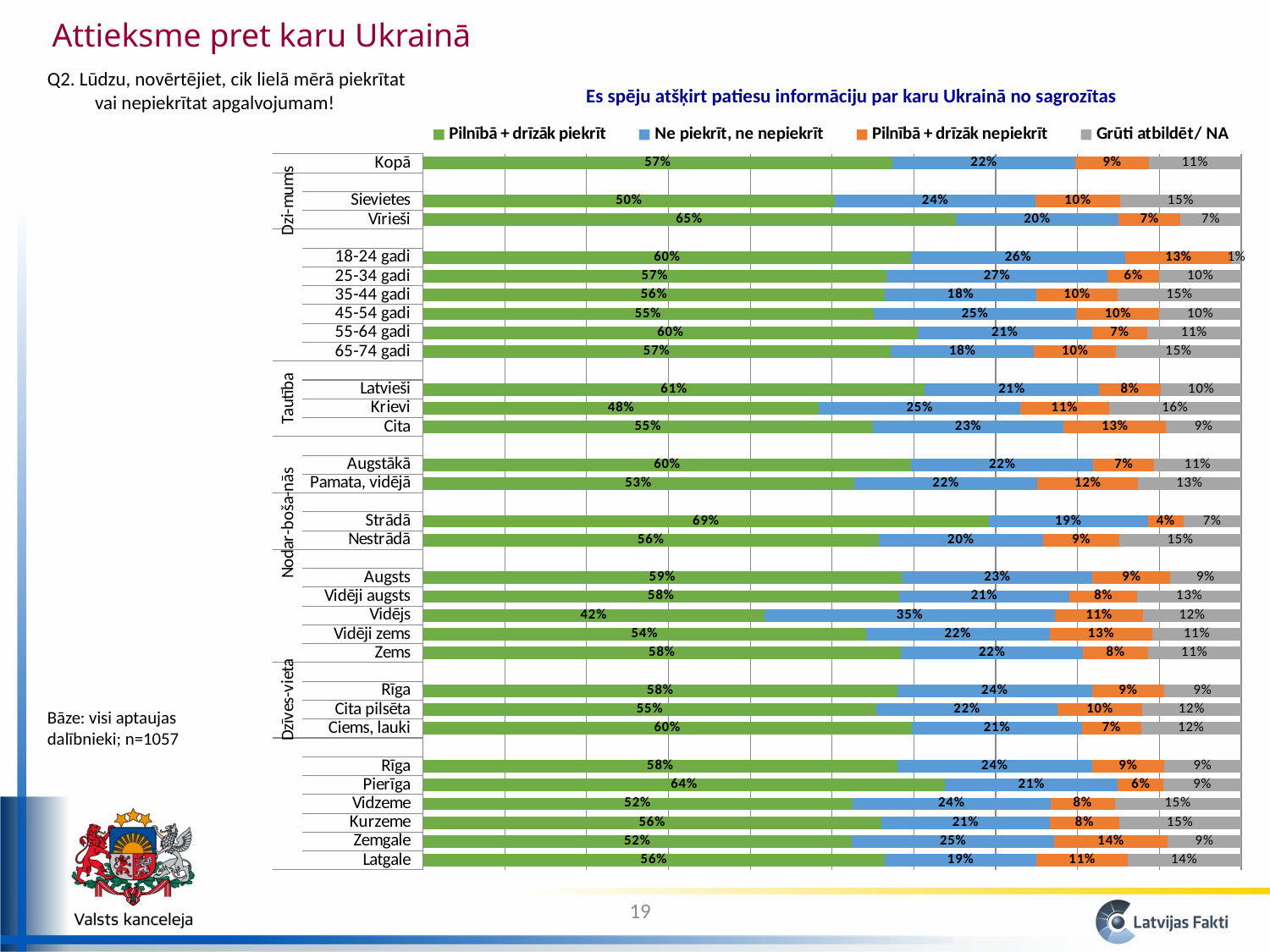
What kind of chart is shown on the slide? Stacked bar chart What is the value of "Grūti atbildēt/ NA" for 18-24 gadi? 1% What is the value of "Ne piekrīt, ne nepiekrīt" for Vidējs? 35% What is the value of "Pilnībā + drīzāk nepiekrīt" for Strādā? 4% What is the value of "Grūti atbildēt/ NA" for Krievi? 16% Which has a larger "Pilnībā + drīzāk nepiekrīt" value, Zemgale or Pierīga? Zemgale What is the value of "Pilnībā + drīzāk piekrīt" for Kopā? 57% What is the title of the chart? Es spēju atšķirt patiesu informāciju par karu Ukrainā no sagrozītas Which category has the lowest value for "Pilnībā + drīzāk piekrīt"? Vidējs What is the difference between the "Pilnībā + drīzāk piekrīt" values for Vīrieši and Sievietes? 15% Which category has the highest value for "Pilnībā + drīzāk piekrīt"? Strādā How many series does the legend list? 4